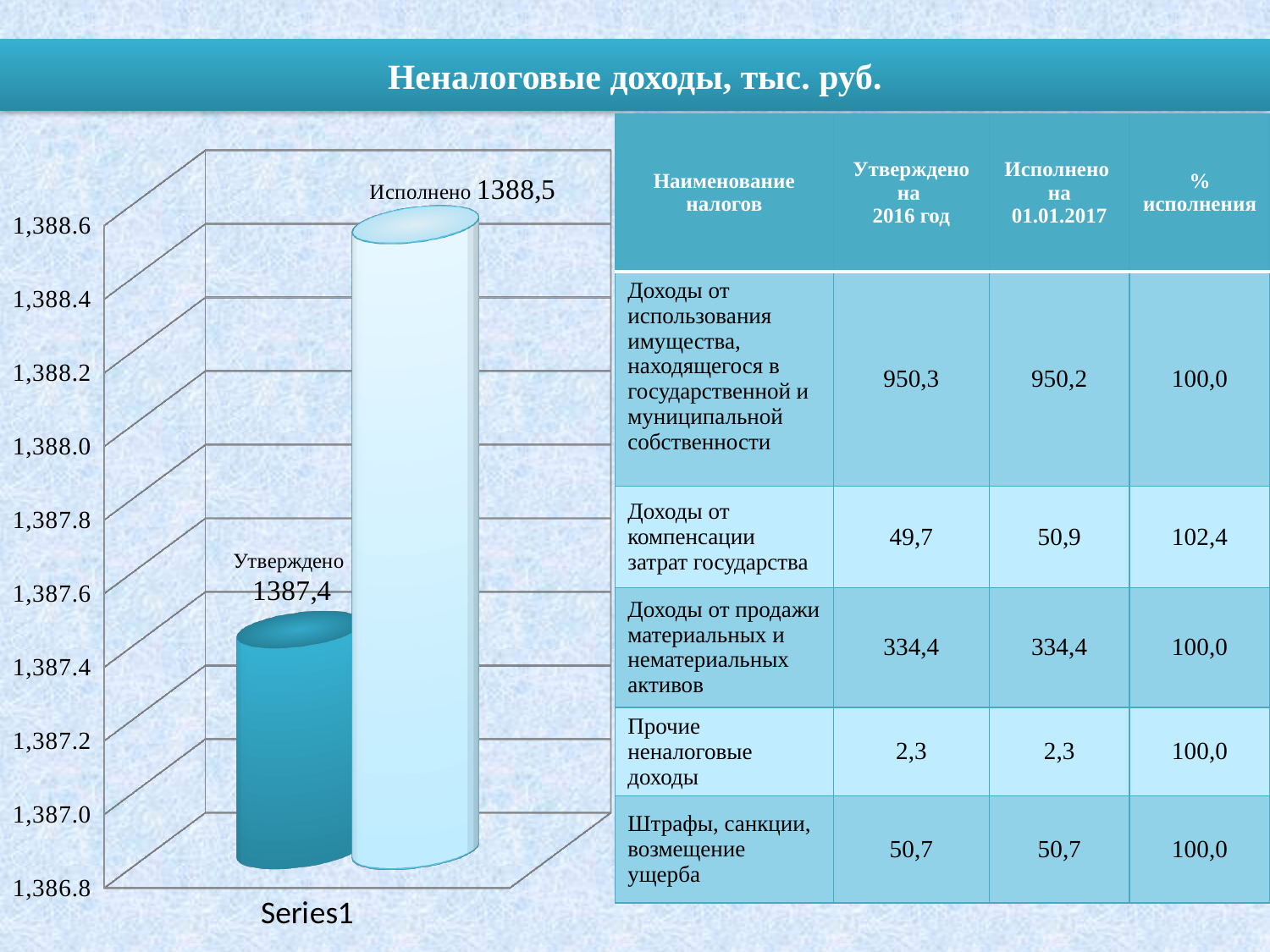
What label appears on the category axis below the bars? Series1 What is the value of the Исполнено bar? 1388,5 How many bars are plotted in the chart? 2 Is the value for Исполнено greater or less than 1,388.0? greater Is the value for Утверждено larger or smaller than the value for Исполнено? smaller Is the value for Утверждено greater or less than 1,388.0? less What kind of chart is shown on the slide? bar chart Which bar is higher, Утверждено or Исполнено? Исполнено Which bar has the lowest value? Утверждено What is the value of the Утверждено bar? 1387,4 What is the title of the slide above the chart? Неналоговые доходы, тыс. руб. What is the difference between the Исполнено and Утверждено values? 1,1